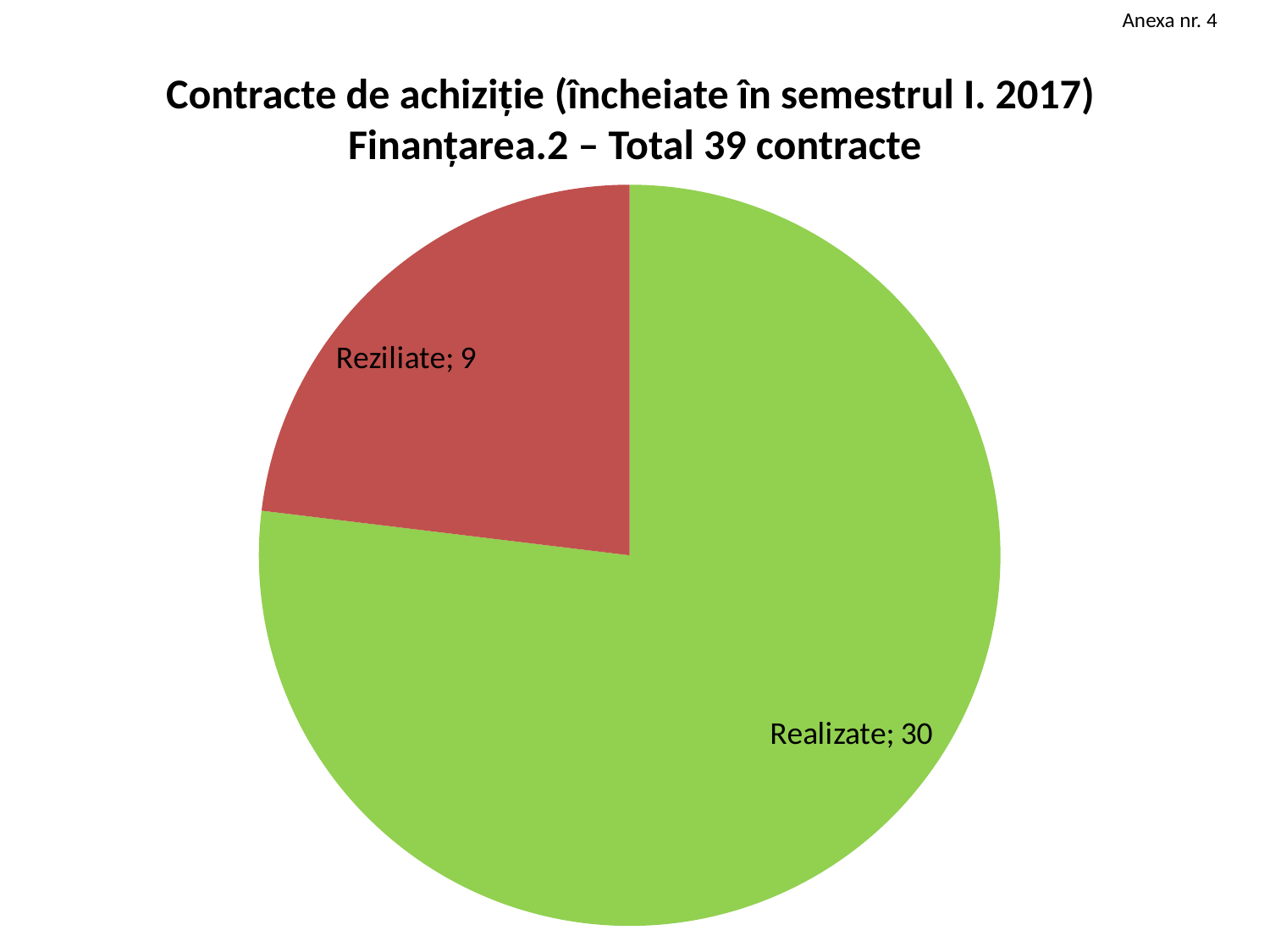
What is the total number of contracts shown in the pie chart? 39 What colour is the Realizate slice? green How many contracts are labelled as Realizate? 30 Which slice of the pie is the smallest? Reziliate What is the title of the chart? Contracte de achiziție (încheiate în semestrul I. 2017) Finanțarea.2 – Total 39 contracte Which slice of the pie is the largest? Realizate What kind of chart is shown on the slide? pie chart Which is larger, Realizate or Reziliate? Realizate How many contracts are labelled as Reziliate? 9 How many slices does the pie chart have? 2 What is the difference between the number of Realizate and Reziliate contracts? 21